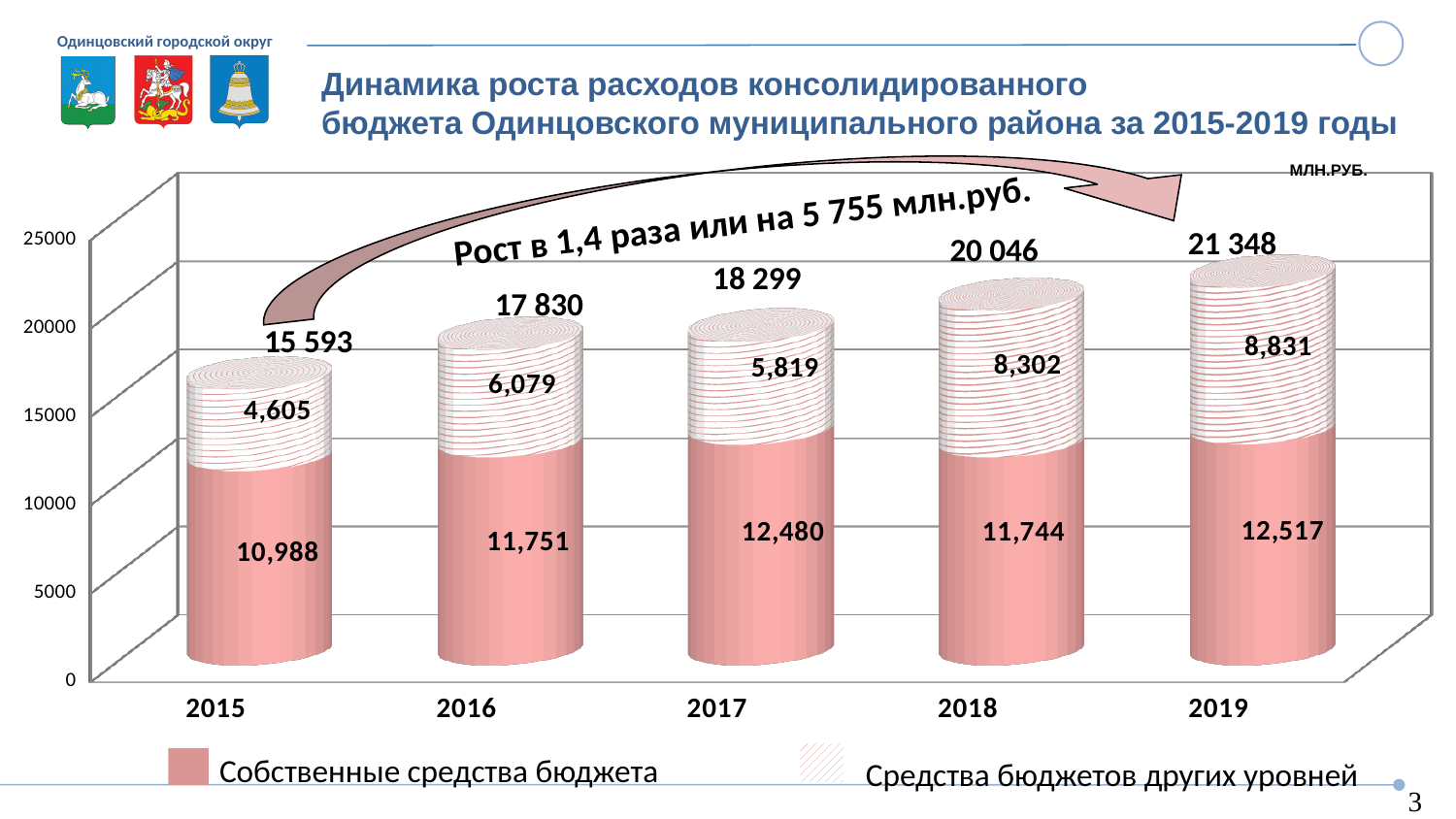
Is the total for 2018 greater or less than 20000? greater What is the value of 'Средства бюджетов других уровней' for 2018? 8,302 Which is larger: 'Собственные средства бюджета' in 2016 or in 2018? 2016 Do the total values rise or fall from 2015 to 2019? Rise How many series does the legend list? 2 What is the value of 'Собственные средства бюджета' for 2017? 12,480 What is the total shown above the bar for 2019? 21 348 What is the difference between the 'Собственные средства бюджета' values for 2019 and 2015? 1,529 Which year has the lowest value for 'Средства бюджетов других уровней'? 2015 How many years are shown on the x axis? 5 What kind of chart is shown on the slide? Stacked bar chart Which year has the highest total consolidated budget expenditure? 2019